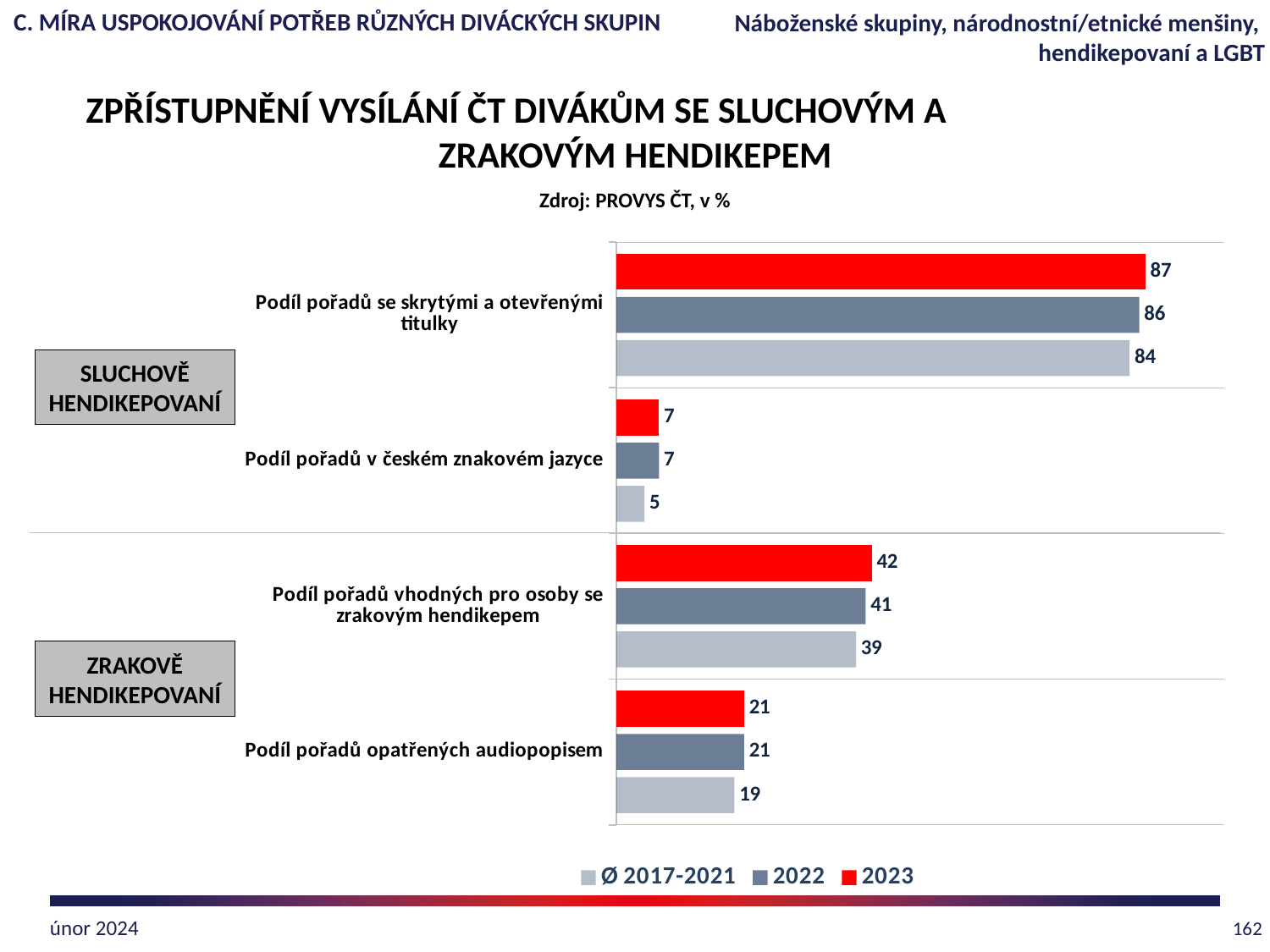
What is the Ø 2017-2021 value for 'Podíl pořadů opatřených audiopopisem'? 19 How many categories are shown in the chart? 4 Which category has the highest 2023 value? Podíl pořadů se skrytými a otevřenými titulky Which category has the lowest 2022 value? Podíl pořadů v českém znakovém jazyce Which is larger: the 2023 value for 'Podíl pořadů opatřených audiopopisem' or the 2023 value for 'Podíl pořadů v českém znakovém jazyce'? Podíl pořadů opatřených audiopopisem What is the 2022 value for 'Podíl pořadů vhodných pro osoby se zrakovým hendikepem'? 41 What kind of chart is shown on the slide? Bar chart What is the Ø 2017-2021 value for 'Podíl pořadů v českém znakovém jazyce'? 5 How many series does the legend list? 3 What is the difference between the 2023 and Ø 2017-2021 values for 'Podíl pořadů vhodných pro osoby se zrakovým hendikepem'? 3 What is the difference between the 2023 and Ø 2017-2021 values for 'Podíl pořadů se skrytými a otevřenými titulky'? 3 What is the 2023 value for 'Podíl pořadů se skrytými a otevřenými titulky'? 87